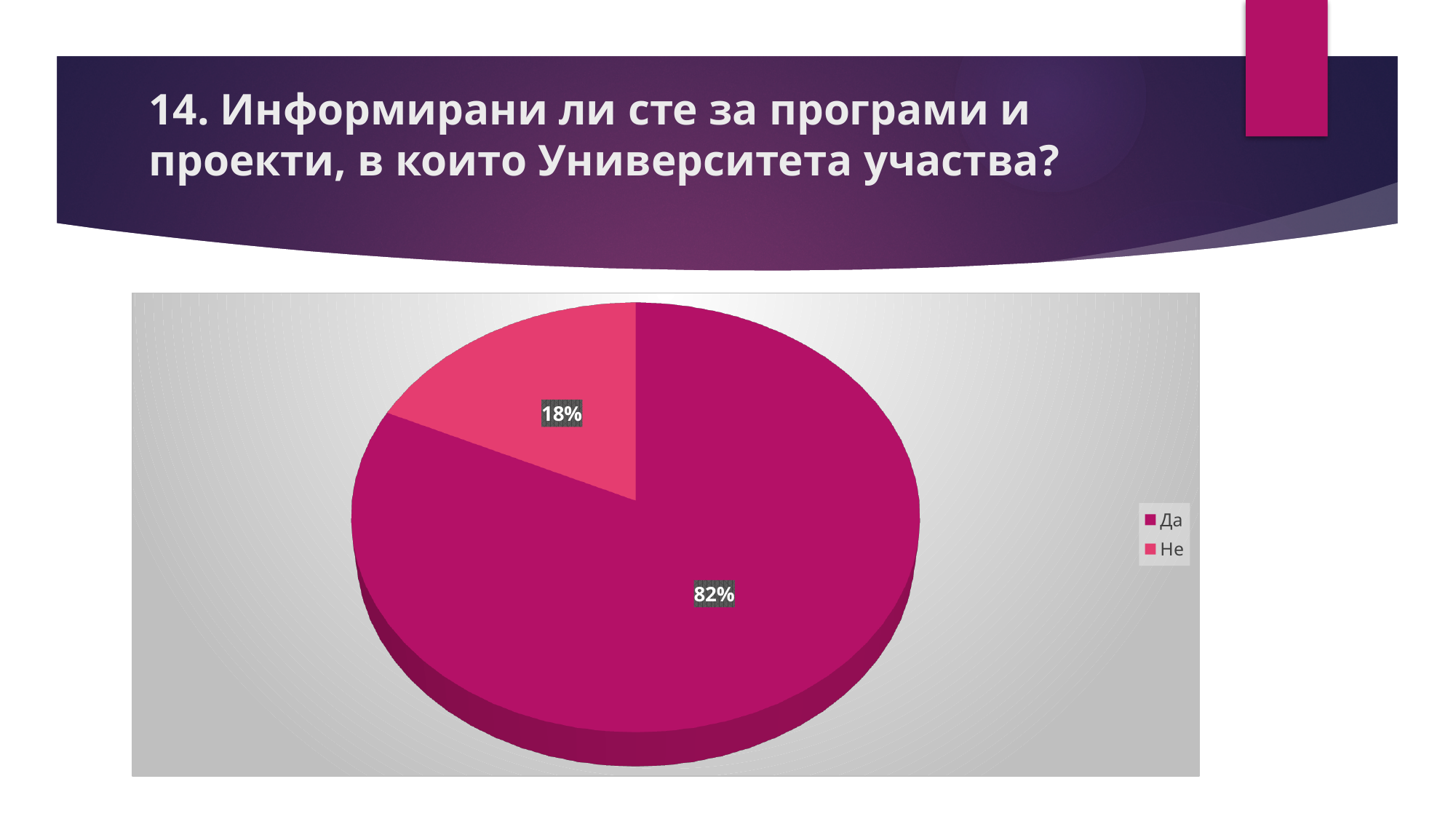
Which legend entry is shown in the lighter pink colour? Не What share of the pie does the "Не" slice represent? 18% What kind of chart is shown on the slide? pie chart What is the title of the slide containing the chart? 14. Информирани ли сте за програми и проекти, в които Университета участва? Which slice is larger, "Да" or "Не"? Да Which category has the largest slice of the pie? Да What is the difference in percentage points between the "Да" and "Не" slices? 64 How many slices does the pie chart have? 2 What share of the pie does the "Да" slice represent? 82% Which category has the smallest slice of the pie? Не How many entries does the legend list? 2